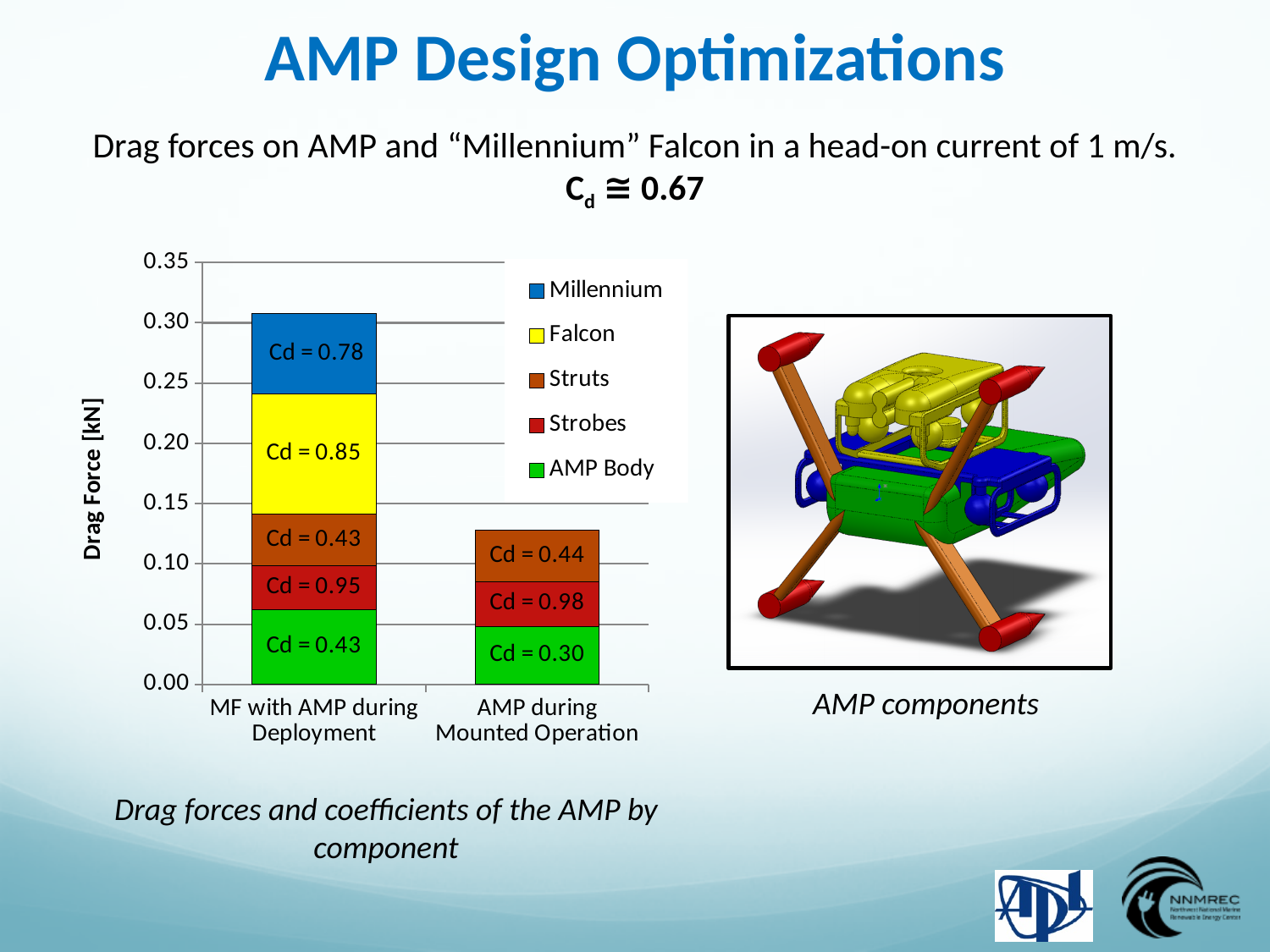
What Cd value is labelled on the Falcon segment of the "MF with AMP during Deployment" bar? Cd = 0.85 Which category has the taller stacked bar, "MF with AMP during Deployment" or "AMP during Mounted Operation"? MF with AMP during Deployment How many series does the chart legend list? 5 What Cd value is labelled on the Millennium segment of the "MF with AMP during Deployment" bar? Cd = 0.78 Is the total drag force for "AMP during Mounted Operation" greater or less than 0.15 kN? less What is the label of the chart's vertical axis? Drag Force [kN] Is the total drag force for "MF with AMP during Deployment" greater or less than 0.25 kN? greater What Cd value is labelled on the AMP Body segment of the "AMP during Mounted Operation" bar? Cd = 0.30 How many categories are shown on the x axis of the chart? 2 What Cd value is labelled on the Strobes segment of the "AMP during Mounted Operation" bar? Cd = 0.98 What kind of chart is shown on the slide? Stacked bar chart Which series is shown in green in the chart legend? AMP Body